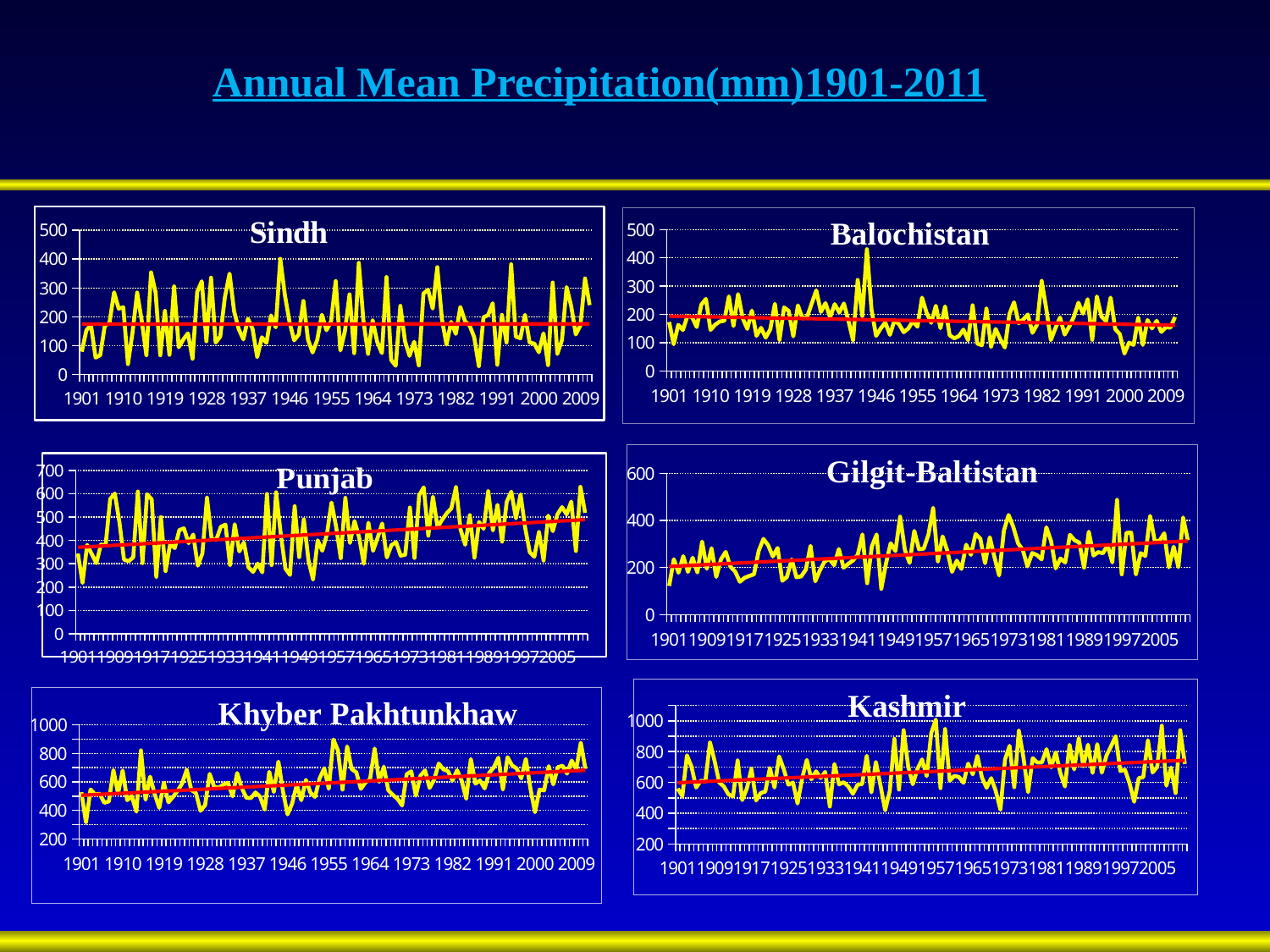
What is the title of the slide? Annual Mean Precipitation(mm)1901-2011 In the Gilgit-Baltistan chart, is the trend line value at 1901 greater or less than 400? less In the Punjab chart, does the red trend line rise or fall from 1901 to 2005? rises In the Gilgit-Baltistan chart, does the red trend line rise or fall across the years? rises In the Sindh chart, is the trend line value at 1901 greater or less than 100? greater In the Kashmir chart, does the red trend line rise or fall across the years? rises What colour is the trend line in each chart? red How many charts are shown on the slide? 6 In the Punjab chart, is the trend line value at 2005 greater or less than 400? greater What kind of chart is the Sindh chart? line chart